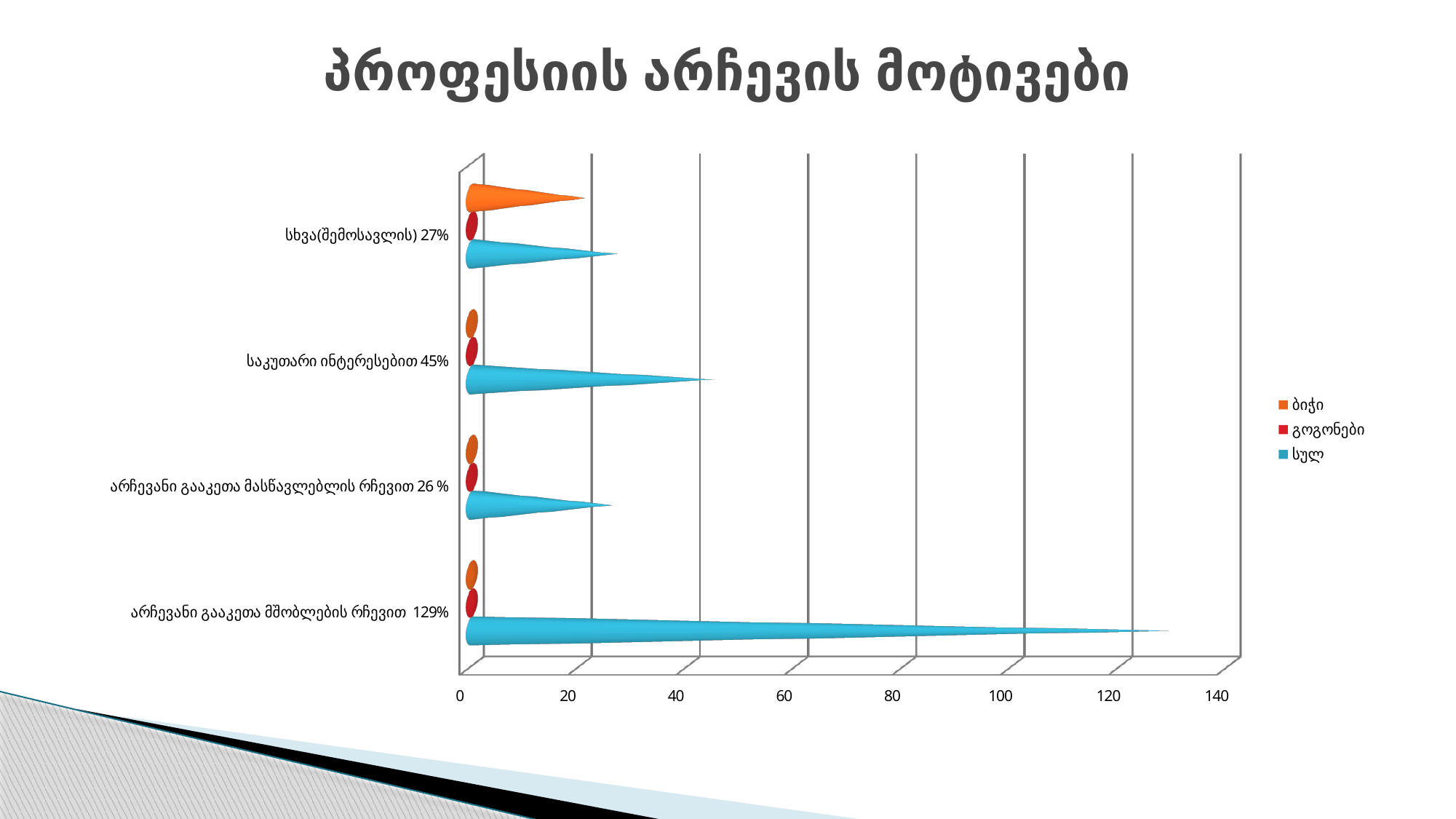
Is the სულ value for სხვა(შემოსავლის) 27% greater or less than 40? less Is the ბიჭი value for სხვა(შემოსავლის) 27% greater or less than 40? less How many categories are shown on the chart? 4 What kind of chart is shown on the slide? bar chart Which category has the highest value for the სულ series? არჩევანი გააკეთა მშობლების რჩევით 129% Which has the larger სულ value: საკუთარი ინტერესებით 45% or სხვა(შემოსავლის) 27%? საკუთარი ინტერესებით 45% Which series is shown in blue in the legend? სულ What is the title of the chart on the slide? პროფესიის არჩევის მოტივები For სხვა(შემოსავლის) 27%, which series has the larger value: ბიჭი or სულ? სულ How many series does the legend list? 3 Is the სულ value for არჩევანი გააკეთა მშობლების რჩევით 129% greater or less than 120? greater